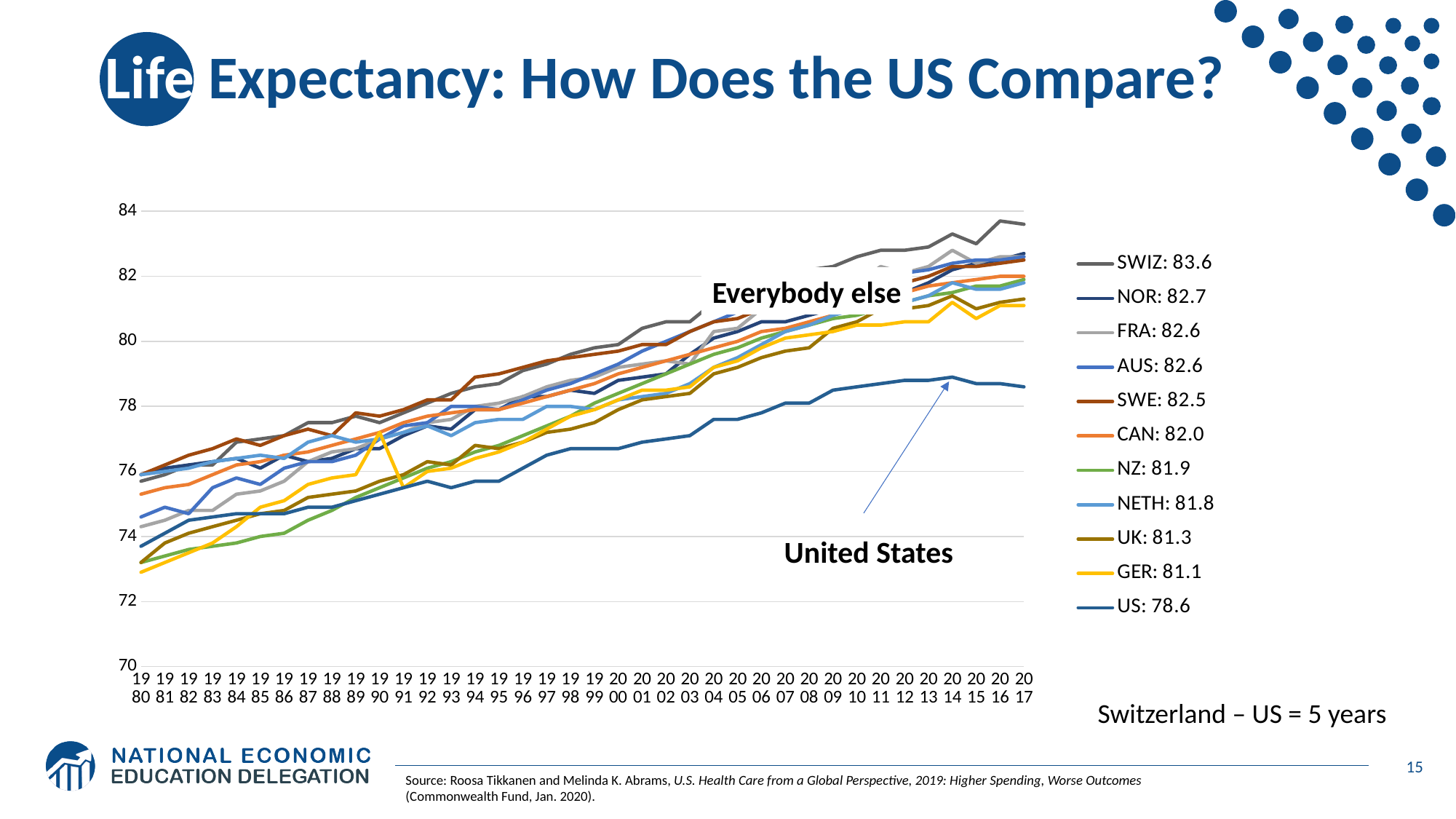
What kind of chart is shown on the slide? line chart Which country has the lowest life expectancy value in the legend? US How many years are shown on the x axis? 38 Which country has the highest life expectancy value in the legend? SWIZ Which has the larger legend value, NOR or CAN? NOR Does the US line rise or fall from 1980 to 2017? rise What is the life expectancy value shown for the US in the legend? 78.6 How many series does the legend list? 11 What is the difference between the SWIZ value and the US value shown in the legend? 5.0 What text annotation is placed below the chart on the right, summarizing the gap between Switzerland and the US? Switzerland – US = 5 years Is the value for the US line in 2000 greater or less than 78? less What is the life expectancy value shown for SWIZ in the legend? 83.6